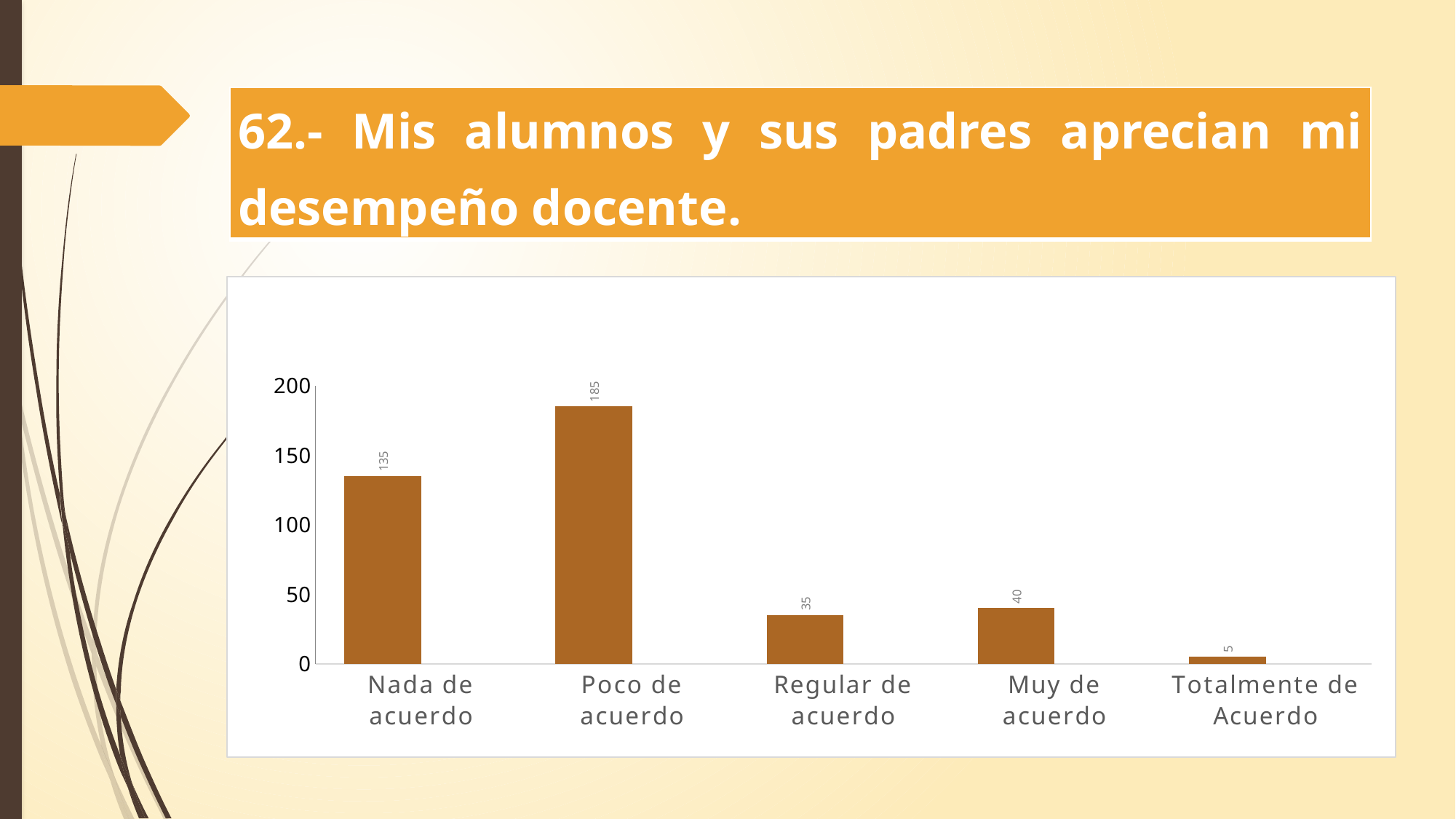
What is the difference between the values for "Poco de acuerdo" and "Nada de acuerdo"? 50 Which category has the highest value? Poco de acuerdo What is the value for "Poco de acuerdo"? 185 Which is larger, the value for "Regular de acuerdo" or the value for "Muy de acuerdo"? Muy de acuerdo What is the value for "Muy de acuerdo"? 40 What is the value for "Totalmente de Acuerdo"? 5 Is the value for "Nada de acuerdo" greater or less than 100? greater How many categories are shown on the x axis? 5 Which category has the lowest value? Totalmente de Acuerdo What is the title text shown above the chart? 62.- Mis alumnos y sus padres aprecian mi desempeño docente. What is the value for "Nada de acuerdo"? 135 What kind of chart is shown on the slide? Bar chart